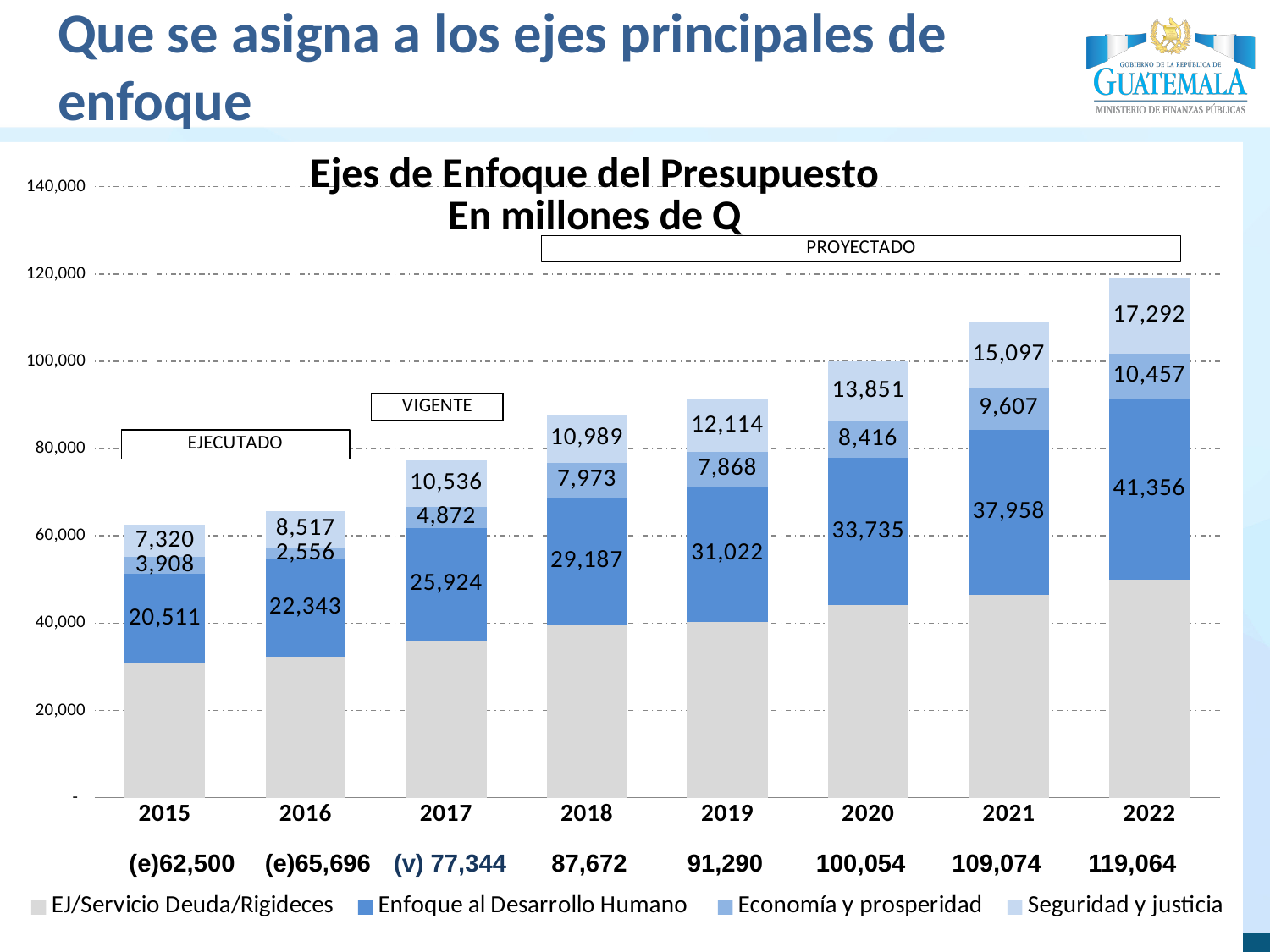
What is the value for Seguridad y justicia in 2022? 17,292 In which year is the Enfoque al Desarrollo Humano value the highest? 2022 How many years are shown on the x axis? 8 What kind of chart is shown on the slide? Stacked bar chart In which year is the Economía y prosperidad value the lowest? 2016 What is the total of the stacked bar for 2020? 100,054 How many series does the legend list? 4 Which is larger: Seguridad y justicia in 2017 or Economía y prosperidad in 2021? Seguridad y justicia in 2017 Is the value for EJ/Servicio Deuda/Rigideces in 2015 greater or less than 40,000? less What is the value for Enfoque al Desarrollo Humano in 2018? 29,187 What is the difference between the Enfoque al Desarrollo Humano values for 2022 and 2021? 3,398 What is the value for Economía y prosperidad in 2020? 8,416